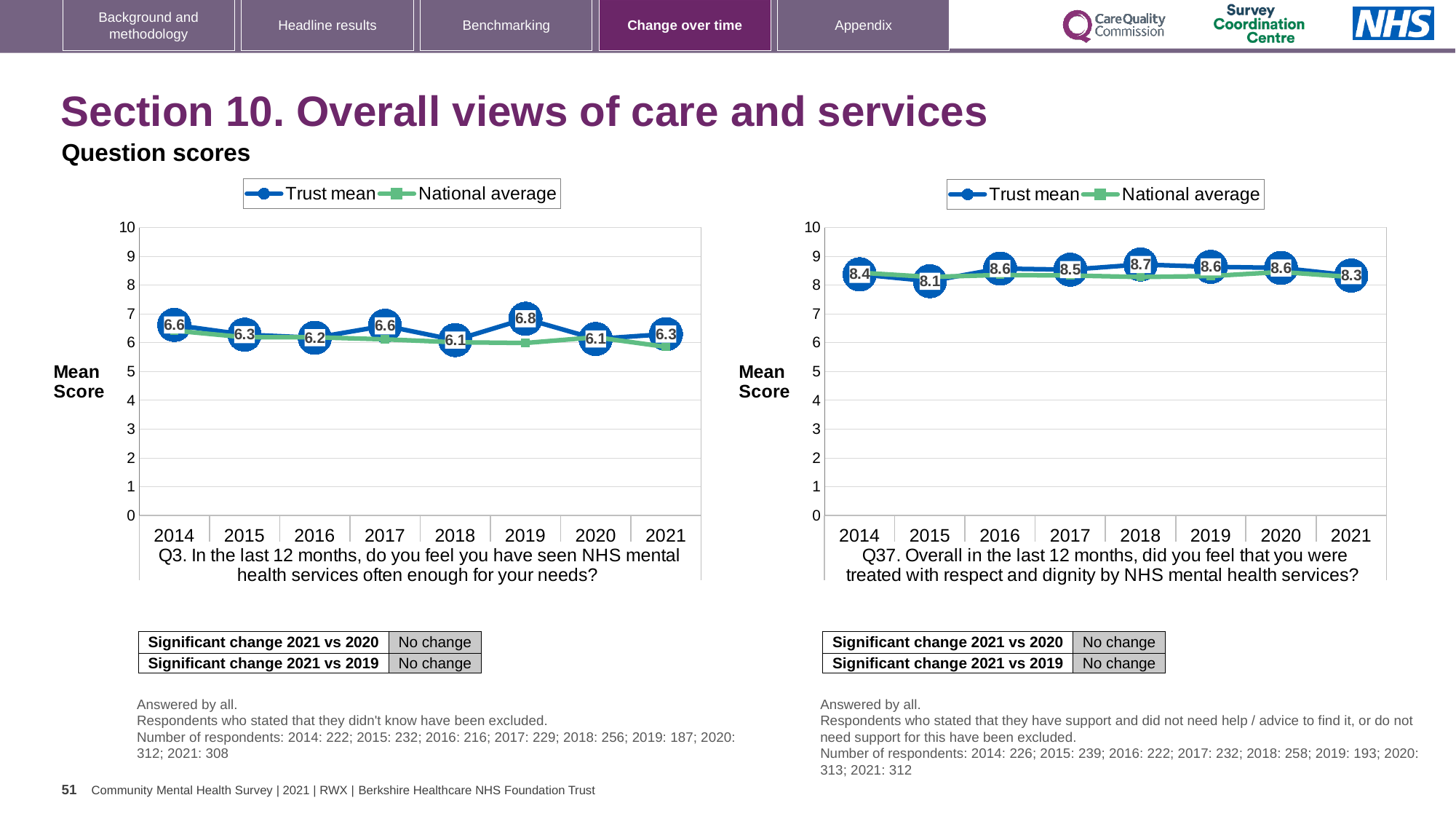
What type of chart is the left chart (Q3)? Line chart In the left chart (Q3), how many years are plotted on the x axis? 8 In the right chart (Q37), what is the Trust mean for 2018? 8.7 In the right chart (Q37), what is the Trust mean for 2015? 8.1 In the left chart (Q3), what is the Trust mean for 2021? 6.3 In the left chart (Q3), which year has the highest Trust mean? 2019 In the left chart (Q3), what is the difference between the Trust mean in 2019 and in 2020? 0.7 How many series does the legend of the right chart (Q37) list? 2 In the right chart (Q37), is the Trust mean higher in 2016 or in 2021? 2016 In the left chart (Q3), what is the Trust mean for 2019? 6.8 In the right chart (Q37), which year has the lowest Trust mean? 2015 In the right chart (Q37), is the Trust mean for 2014 greater or less than 8? greater